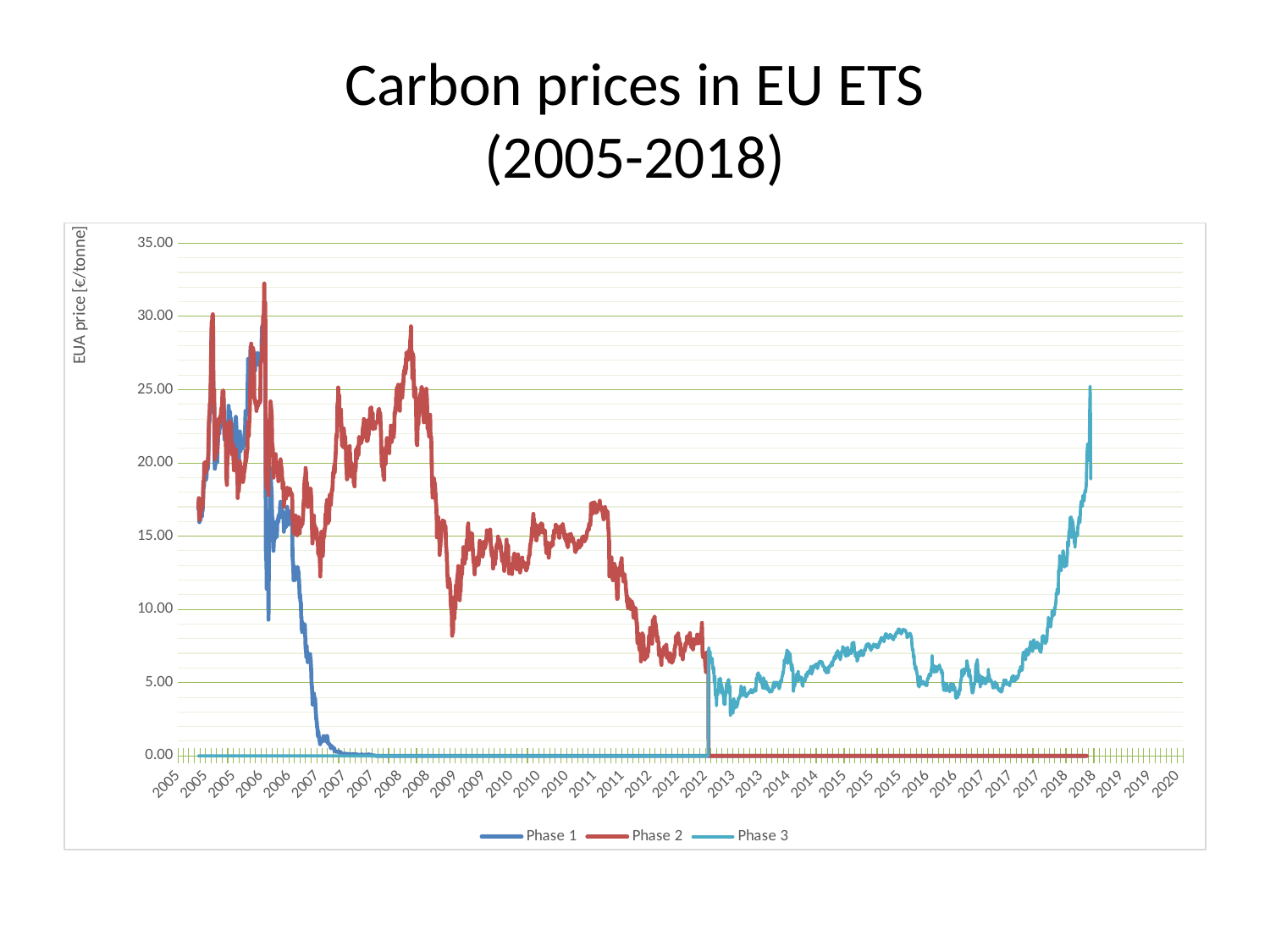
What is the label on the vertical axis of the chart? EUA price [€/tonne] What is the title of the chart on the slide? Carbon prices in EU ETS (2005-2018) Does the Phase 3 price rise or fall from 2017 to 2018? Rise Which series reaches a higher peak value, Phase 2 or Phase 3? Phase 2 Does the Phase 1 price rise or fall from 2006 to 2007? Fall What kind of chart is shown on the slide? Line chart How many series does the legend list? 3 Is the value of Phase 1 at the end of 2007 greater or less than 5.00? less Which series reaches the highest EUA price on the chart? Phase 2 Is the peak value of Phase 2 in 2006 greater or less than 30.00? greater Is the value of Phase 3 in 2016 greater or less than 10.00? less